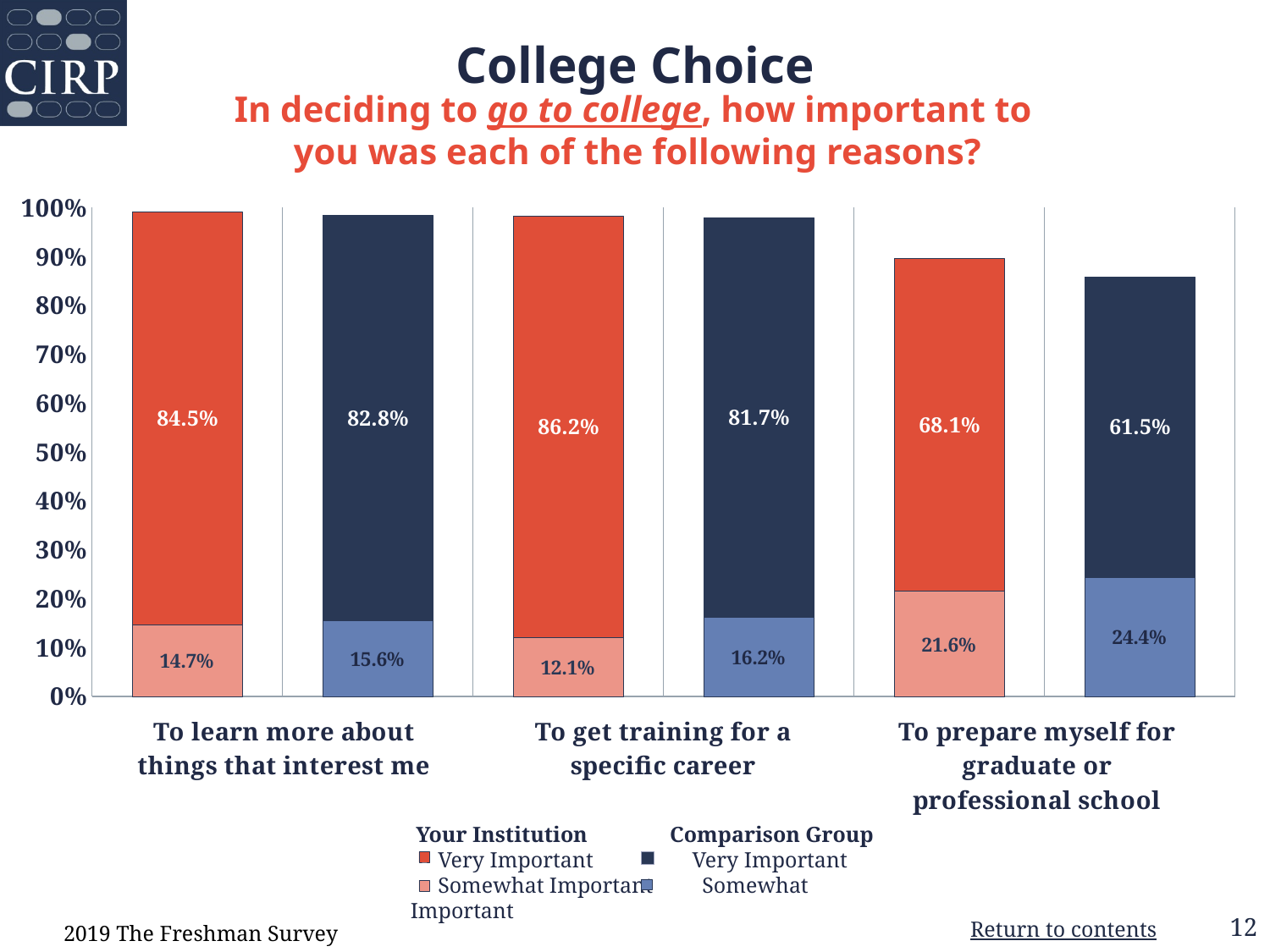
What percentage of the Comparison Group rated "To get training for a specific career" as Very Important? 81.7% Which reason has the lowest Very Important percentage for the Comparison Group? To prepare myself for graduate or professional school Which reason has the highest Very Important percentage for Your Institution? To get training for a specific career What kind of chart is shown on the slide? Stacked bar chart How many reasons (categories) are shown on the x axis of the chart? 3 What is the difference between Your Institution and the Comparison Group in the Very Important percentage for "To prepare myself for graduate or professional school"? 6.6 percentage points For "To get training for a specific career", which group has the larger Very Important percentage, Your Institution or the Comparison Group? Your Institution What percentage of Your Institution students rated "To learn more about things that interest me" as Very Important? 84.5% What is the combined Very Important and Somewhat Important percentage for the Comparison Group for "To learn more about things that interest me"? 98.4% How many series does the legend list? 4 What percentage of the Comparison Group rated "To prepare myself for graduate or professional school" as Somewhat Important? 24.4% What is the combined Very Important and Somewhat Important percentage for Your Institution for "To prepare myself for graduate or professional school"? 89.7%